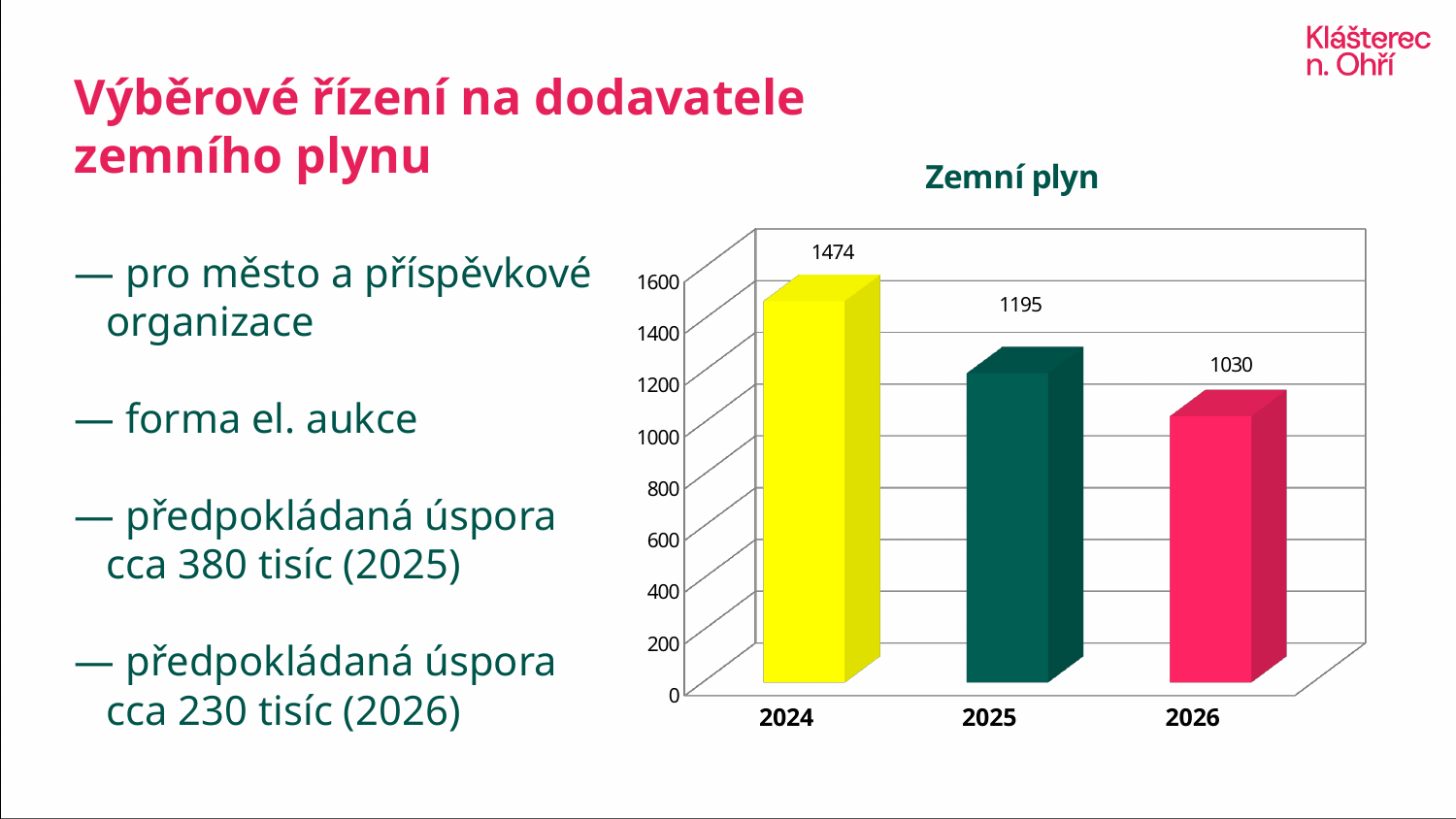
What kind of chart is shown on the slide? bar chart What is the difference between the values for 2024 and 2025? 279 Which is larger, the value for 2025 or the value for 2026? 2025 What is the value for 2024 in the Zemní plyn chart? 1474 Which year has the lowest value in the Zemní plyn chart? 2026 What is the difference between the values for 2025 and 2026? 165 Do the values rise or fall from 2024 to 2026? fall What is the value for 2026 in the Zemní plyn chart? 1030 What is the value for 2025 in the Zemní plyn chart? 1195 How many years are shown on the x axis of the chart? 3 Is the value for 2026 greater or less than 1200? less Which year has the highest value in the Zemní plyn chart? 2024